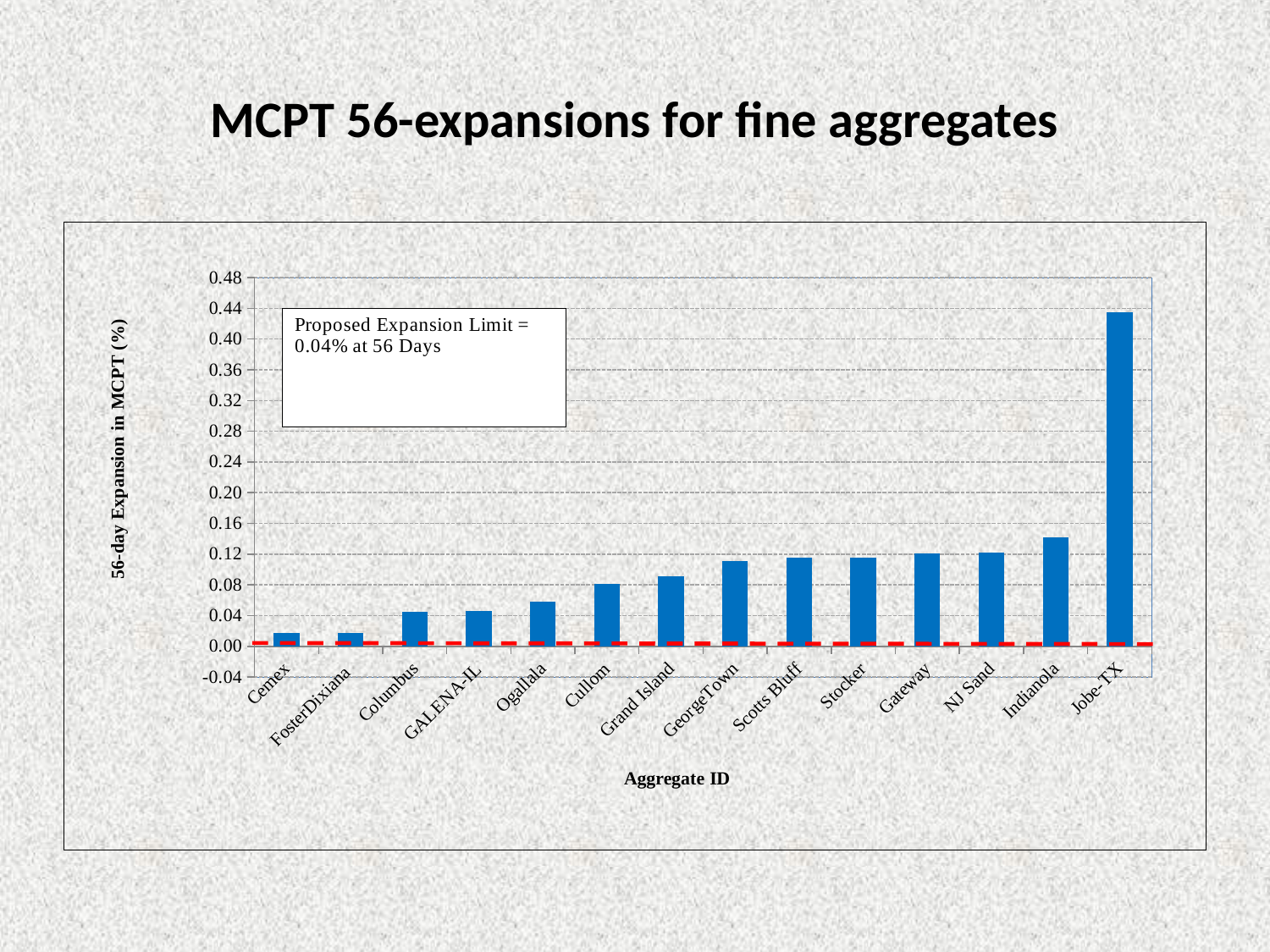
What is the title of the slide? MCPT 56-expansions for fine aggregates Which aggregate has the highest 56-day expansion? Jobe-TX Is the value for Indianola greater or less than 0.12? greater What kind of chart is shown on the slide? bar chart Is the value for Jobe-TX greater or less than 0.40? greater Is the value for Cullom greater or less than 0.12? less Do the bar values generally rise or fall moving from left to right along the x axis? rise Which has a larger 56-day expansion, Columbus or Grand Island? Grand Island What proposed expansion limit is stated in the text box on the chart? 0.04% at 56 Days How many aggregate IDs are plotted along the x axis? 14